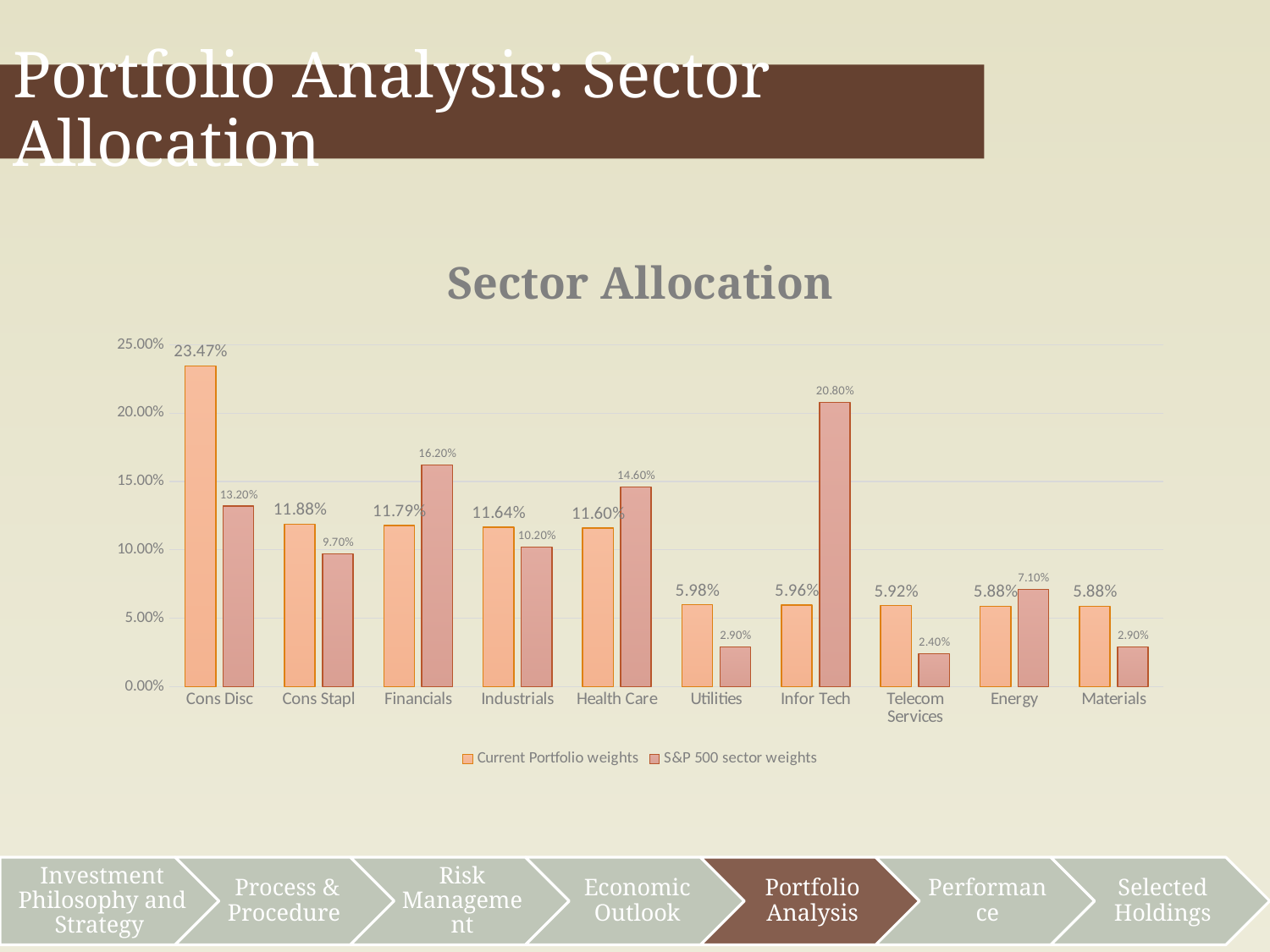
Which sector has the highest S&P 500 sector weight? Infor Tech For Infor Tech, what is the difference between the S&P 500 sector weight and the Current Portfolio weight? 14.84 percentage points For Financials, which is larger: the Current Portfolio weight or the S&P 500 sector weight? S&P 500 sector weight Which sector has the lowest S&P 500 sector weight? Telecom Services What is the S&P 500 sector weight for Infor Tech? 20.80% What is the Current Portfolio weight for Cons Disc? 23.47% How many sectors are shown on the x axis? 10 Which sector has the highest Current Portfolio weight? Cons Disc What type of chart is shown on the slide? Bar chart How many series does the legend list? 2 What is the Current Portfolio weight for Utilities? 5.98% For Cons Disc, how much higher is the Current Portfolio weight than the S&P 500 sector weight? 10.27 percentage points